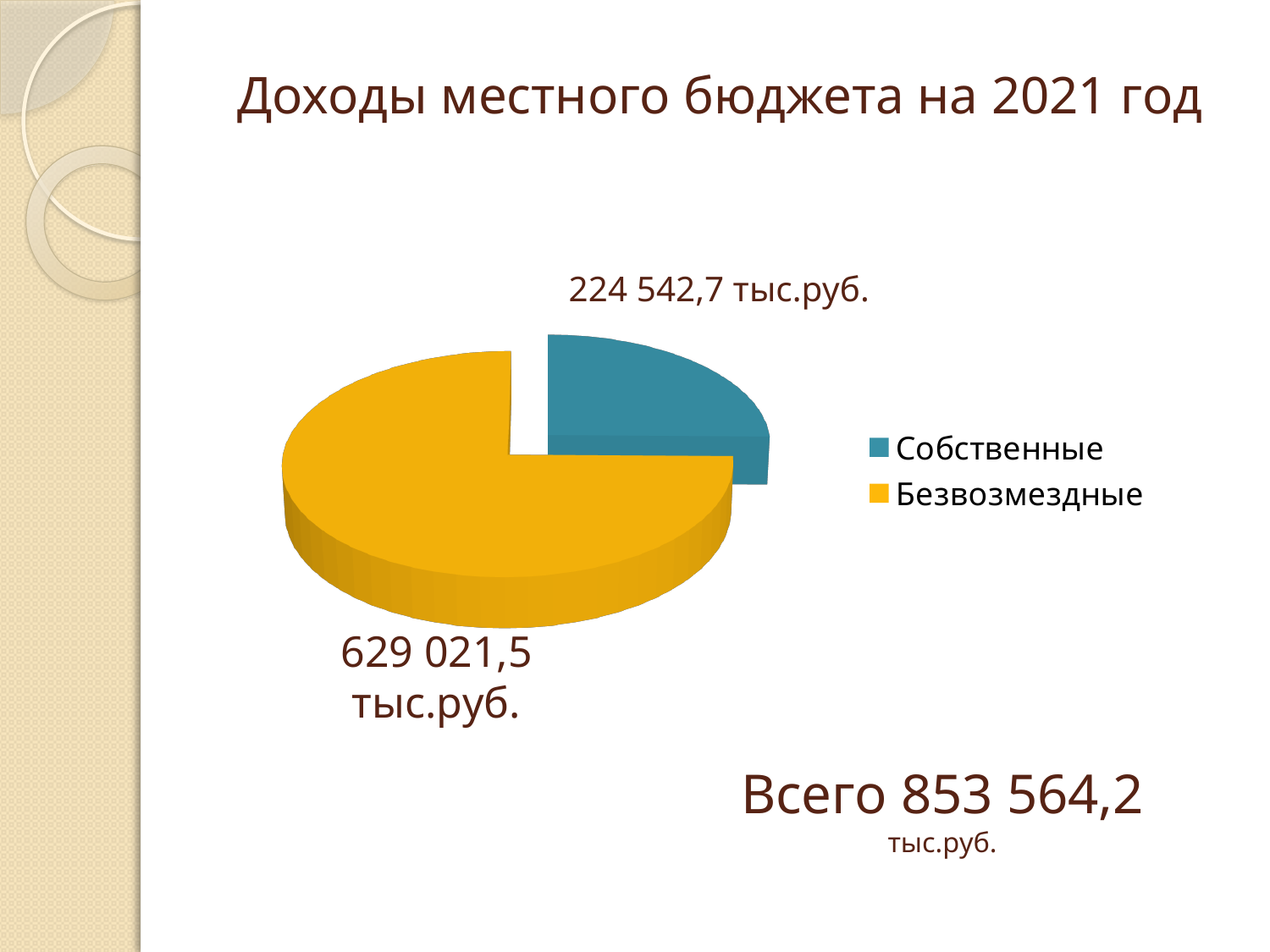
Which category has the smallest value? Собственные Which category has the largest value? Безвозмездные What is the total of all slices in the pie chart? 853 564,2 тыс.руб. How many slices does the pie chart have? 2 What colour is the Безвозмездные slice? Yellow Which is larger, Собственные or Безвозмездные? Безвозмездные What share of the total does the Собственные slice represent, to one decimal place? 26.3% What type of chart is shown on the slide? Pie chart What is the title of the slide? Доходы местного бюджета на 2021 год What is the value of the Собственные slice? 224 542,7 тыс.руб. What is the difference between the Безвозмездные and Собственные values? 404 478,8 тыс.руб. What is the value of the Безвозмездные slice? 629 021,5 тыс.руб.